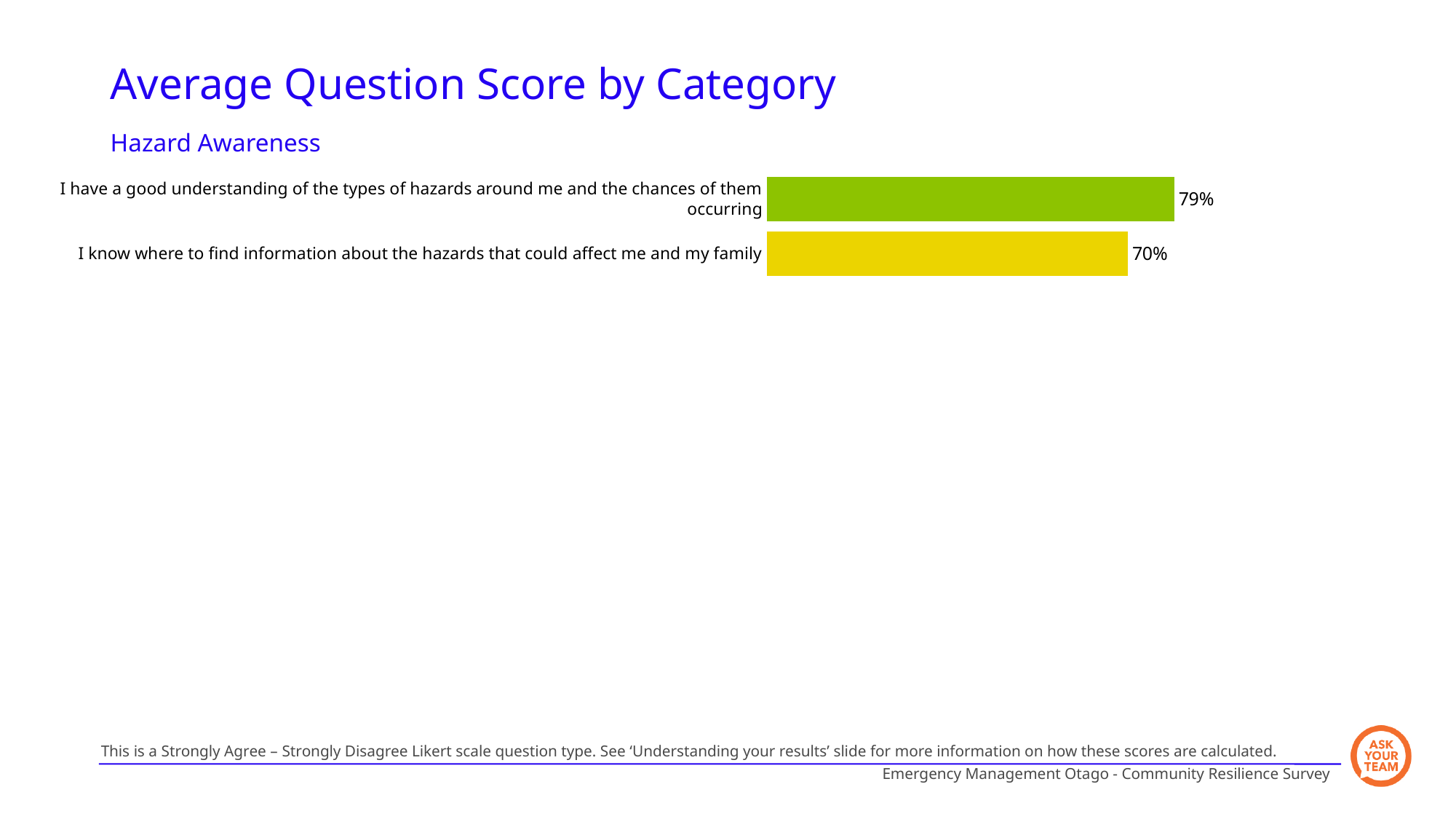
What type of chart is shown on the slide? Bar chart What is the title of the slide? Average Question Score by Category How many questions (bars) are shown in the chart? 2 What is the average score for "I know where to find information about the hazards that could affect me and my family"? 70% What is the average score for "I have a good understanding of the types of hazards around me and the chances of them occurring"? 79% What is the difference between the two average scores shown? 9% Which question has the lowest average score? I know where to find information about the hazards that could affect me and my family Which question has the highest average score? I have a good understanding of the types of hazards around me and the chances of them occurring Which has a higher score: understanding the types of hazards around me, or knowing where to find information about hazards? I have a good understanding of the types of hazards around me and the chances of them occurring Which category do the questions in the chart belong to? Hazard Awareness